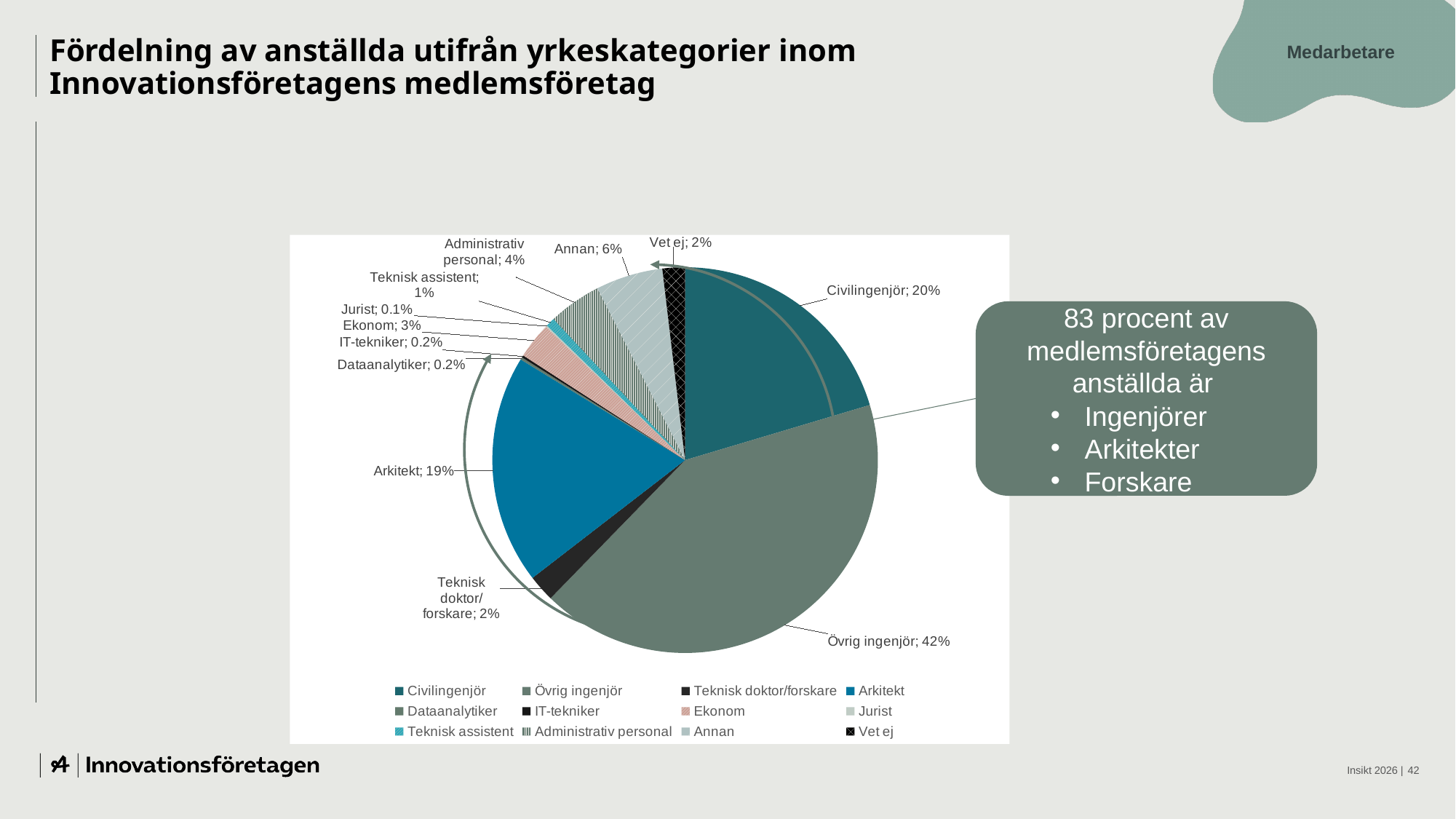
Which is larger, the share for Annan or the share for Administrativ personal? Annan Which category has the smallest share? Jurist What share of employees are Civilingenjör? 20% What is the value shown for Ekonom? 3% What share of employees are Arkitekt? 19% How many categories does the legend list? 12 Which category has the largest slice of the pie? Övrig ingenjör How many percentage points larger is Övrig ingenjör than Civilingenjör? 22 What is the value shown for Administrativ personal? 4% What is the value shown for Vet ej? 2% What kind of chart is shown on the slide? Pie chart What share of employees are Övrig ingenjör? 42%